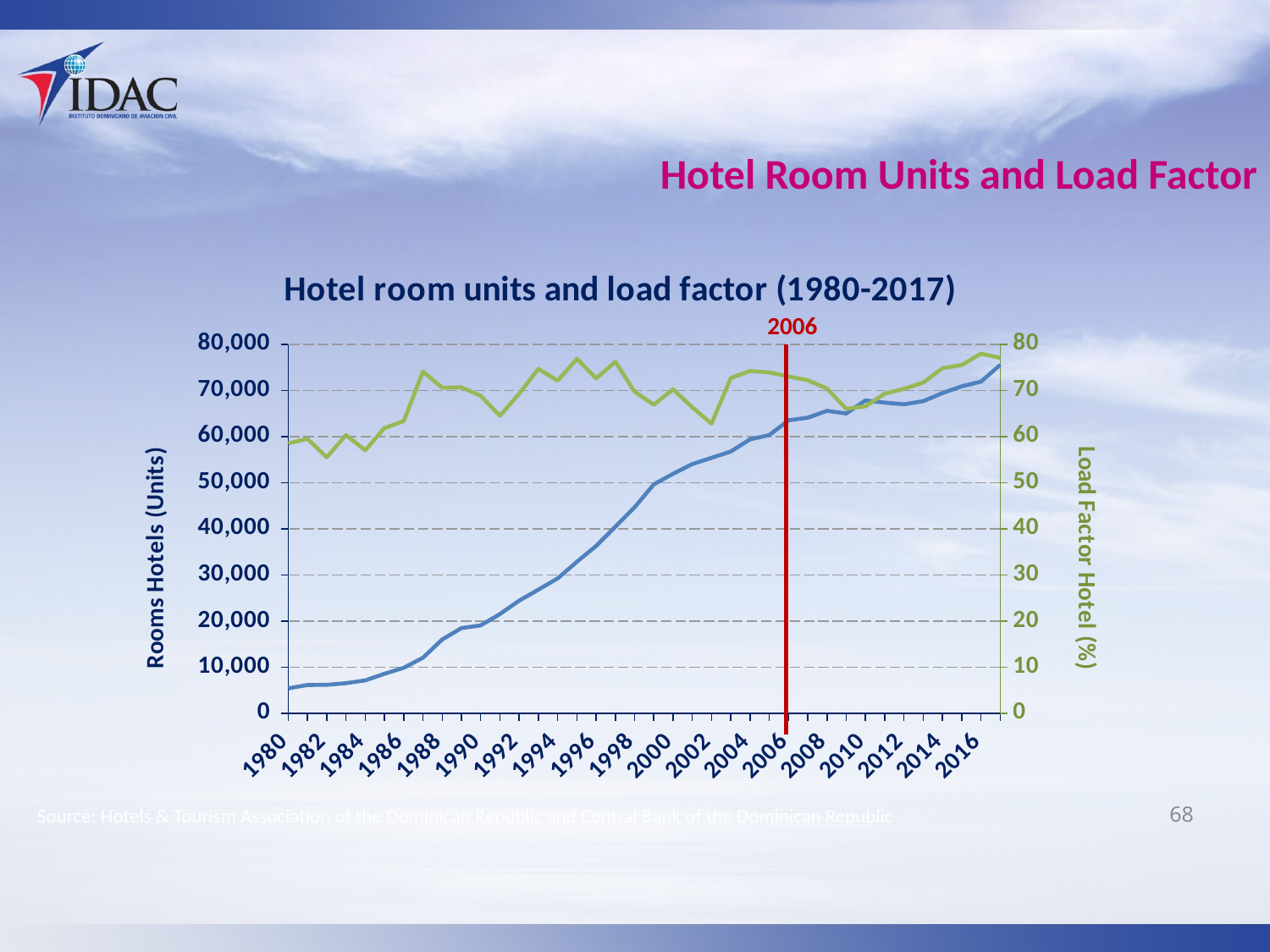
Is the value for hotel room units in 1980 greater or less than 10,000? less Are the hotel room units in 2006 greater or less than 60,000? greater Do the hotel room units rise or fall from 1980 to 2017? Rise What is the title of the chart? Hotel room units and load factor (1980-2017) Is the hotel load factor in 1996 greater or less than 70? greater In which year are the hotel room units highest? 2017 Which year is marked by the red vertical line on the chart? 2006 In which year are the hotel room units lowest? 1980 What kind of chart is shown on the slide? Line chart